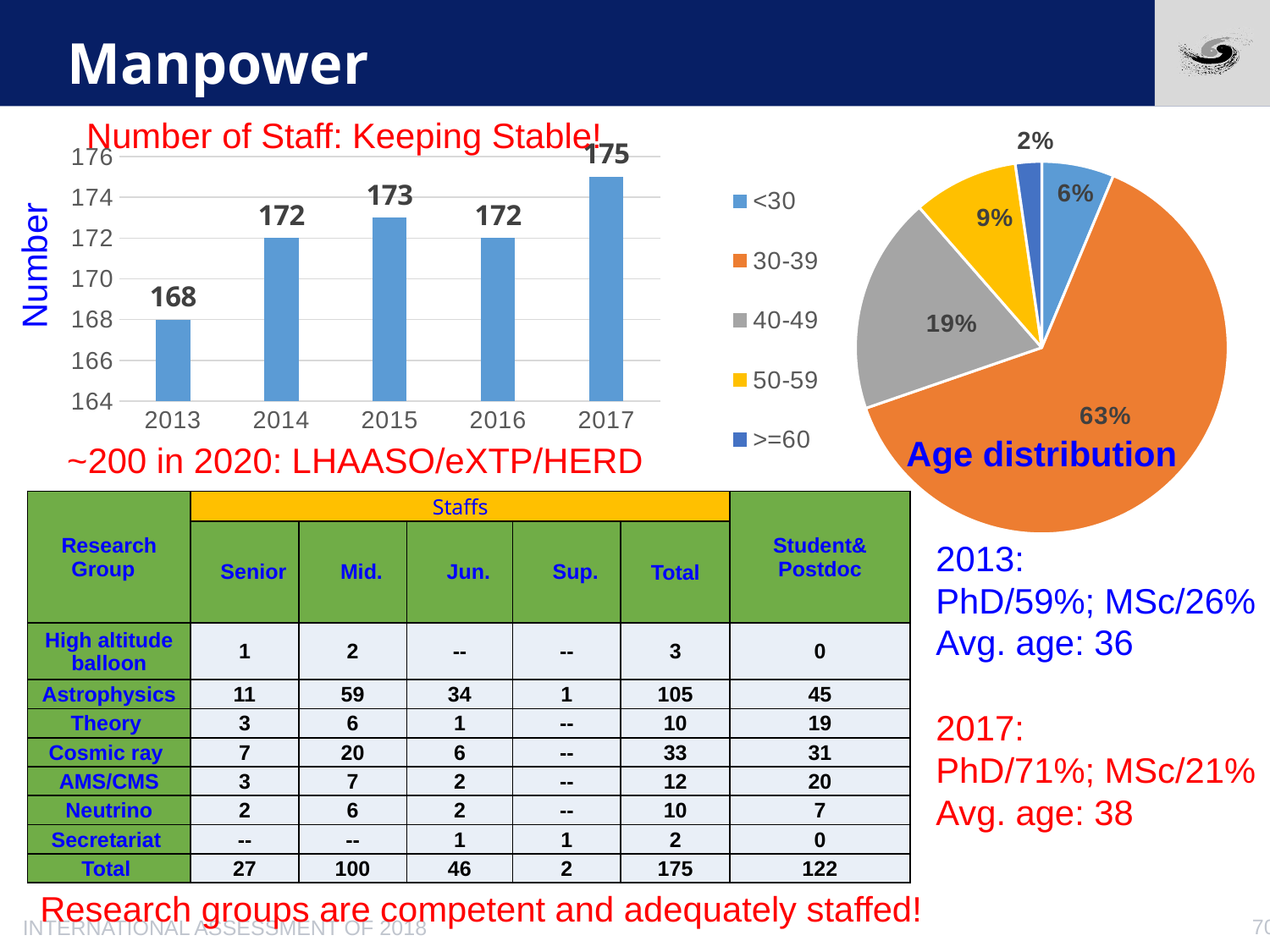
On the 'Age distribution' pie chart, what share of staff is in the 30-39 age group? 63% How many age groups does the legend of the 'Age distribution' pie chart list? 5 On the bar chart 'Number of Staff: Keeping Stable!', what is the number of staff in 2013? 168 On the bar chart 'Number of Staff: Keeping Stable!', what is the number of staff in 2017? 175 On the 'Age distribution' pie chart, which age group has the smallest share? >=60 On the bar chart 'Number of Staff: Keeping Stable!', how many years are shown on the x axis? 5 On the 'Age distribution' pie chart, what share of staff is in the 40-49 age group? 19% On the bar chart 'Number of Staff: Keeping Stable!', is the number of staff in 2015 greater or less than 170? greater On the bar chart 'Number of Staff: Keeping Stable!', which year has the lowest number of staff? 2013 What kind of chart is the 'Number of Staff: Keeping Stable!' chart? bar chart On the bar chart 'Number of Staff: Keeping Stable!', which year has the highest number of staff? 2017 On the bar chart 'Number of Staff: Keeping Stable!', what is the difference between the number of staff in 2017 and in 2013? 7